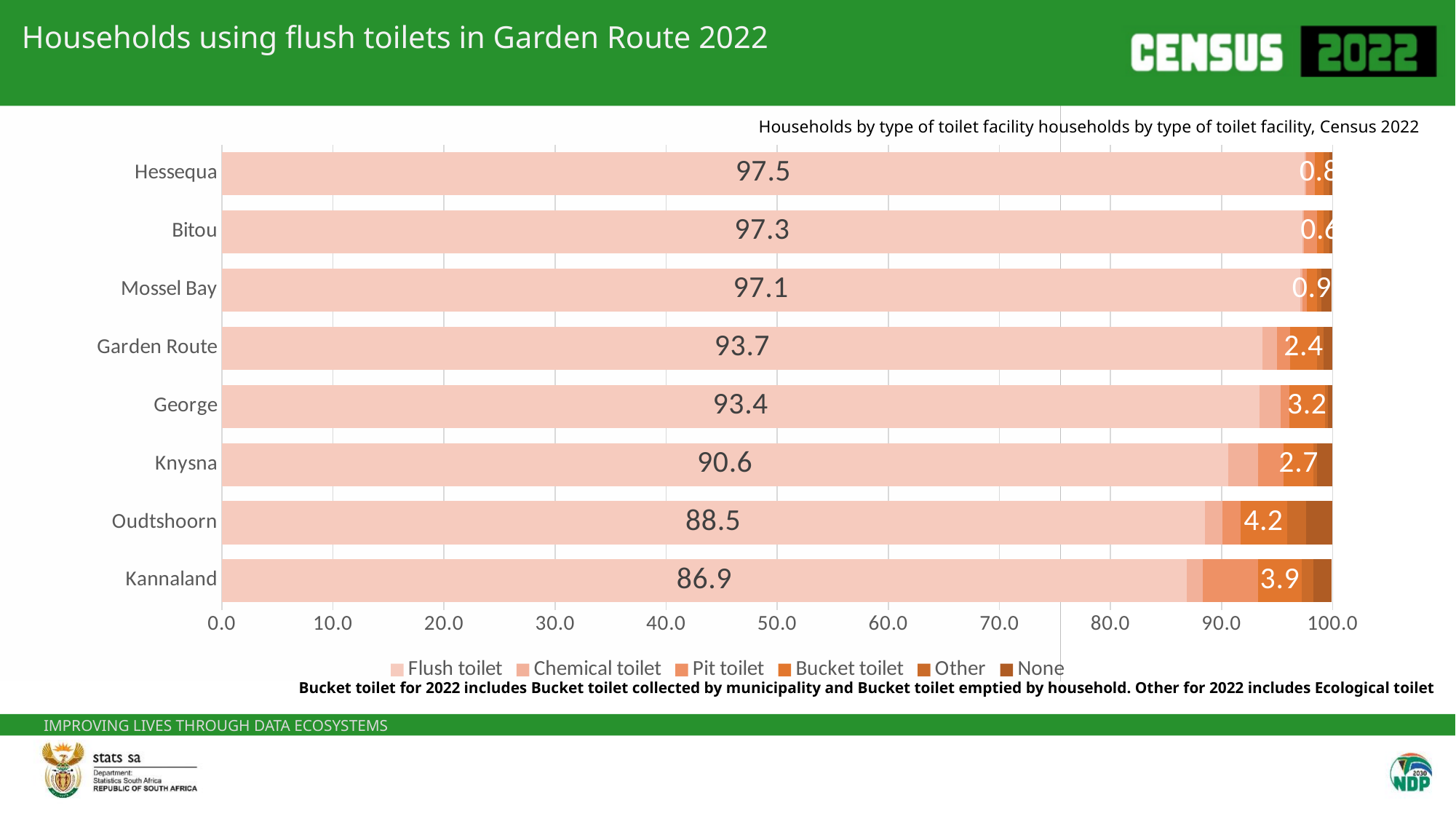
What is the Flush toilet value for Oudtshoorn? 88.5 What is the Flush toilet value for Hessequa? 97.5 Which has a larger Flush toilet value, Knysna or Oudtshoorn? Knysna How many series does the legend list? 6 What is the Flush toilet value for Garden Route? 93.7 What is the Flush toilet value for Kannaland? 86.9 What is the difference between the Flush toilet values for Hessequa and Kannaland? 10.6 Is the Flush toilet value for Kannaland greater or less than 90.0? less Which municipality has the lowest Flush toilet value? Kannaland Which municipality has the highest Flush toilet value? Hessequa How many municipalities are shown on the chart? 8 What kind of chart is shown on the slide? Stacked bar chart